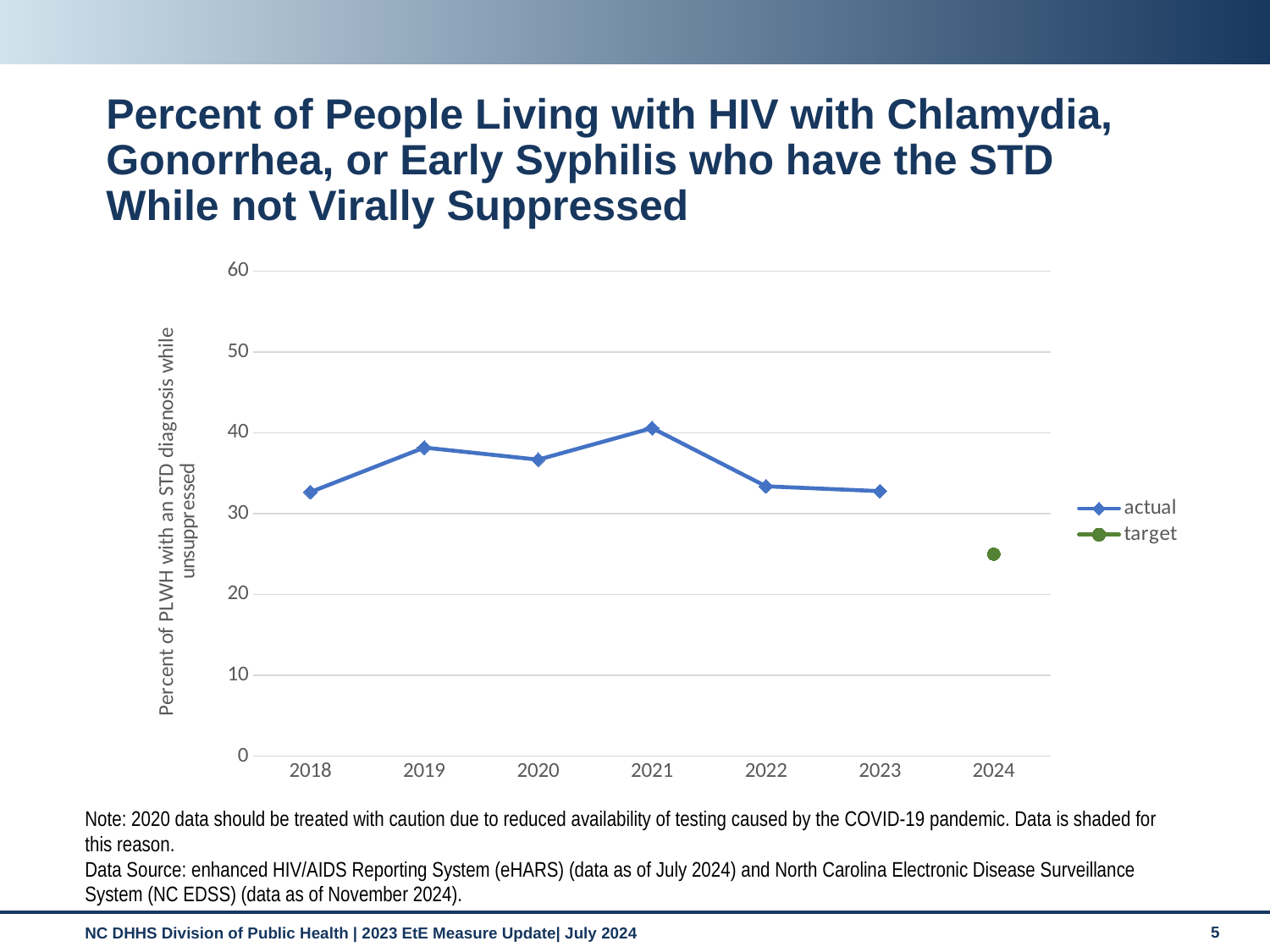
What kind of chart is shown on the slide? line chart Which is larger, the actual value for 2018 or for 2019? 2019 Is the target value for 2024 greater or less than 30? less Is the actual value for 2019 greater or less than 40? less How many years are shown on the x axis? 7 Is the actual value for 2021 greater or less than 30? greater Does the actual series rise or fall from 2021 to 2023? fall Which year has the highest value for the actual series? 2021 Which is larger, the actual value for 2021 or for 2022? 2021 How many series does the legend list? 2 What are the two series named in the legend? actual and target